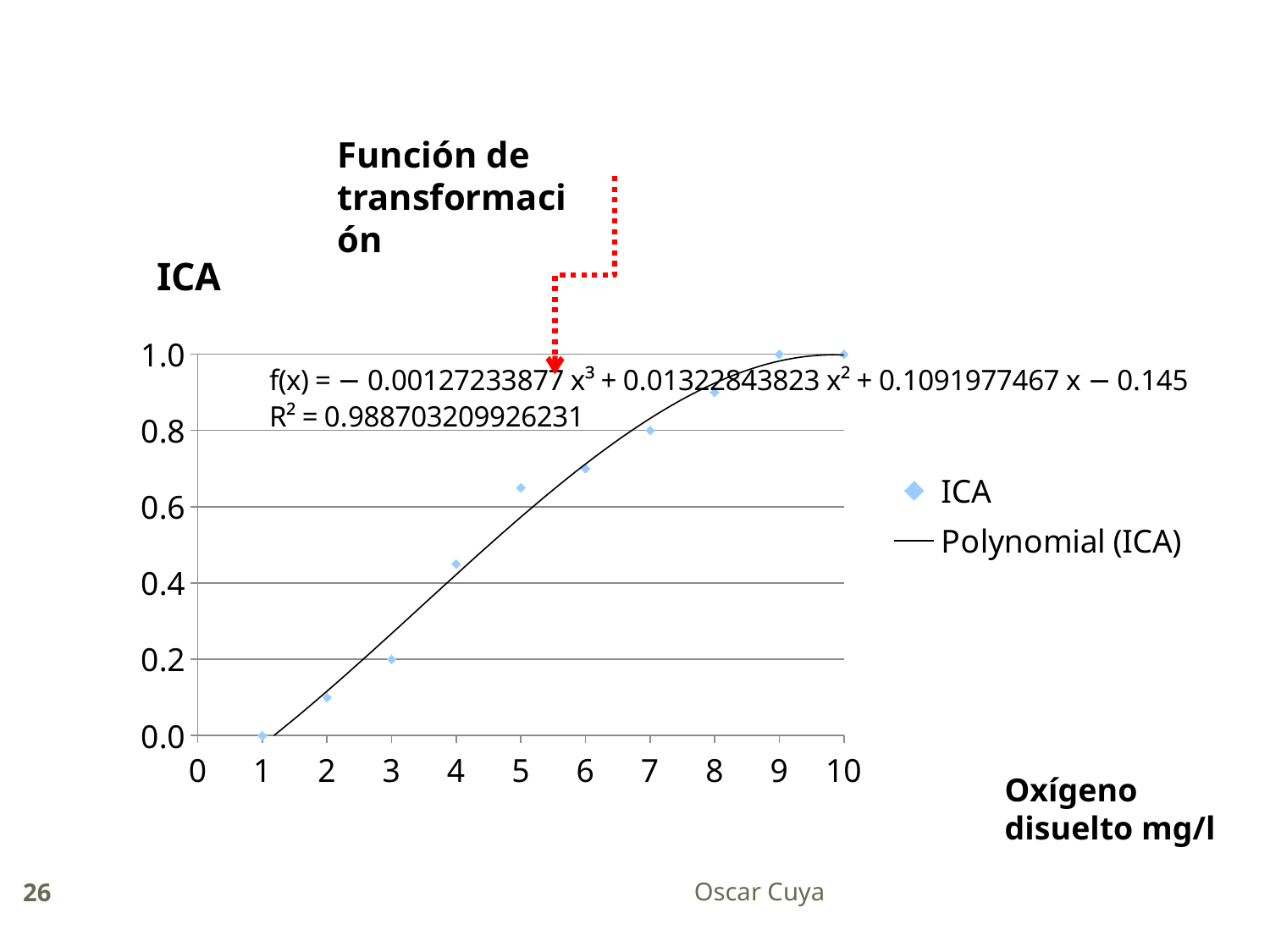
Do the ICA values rise or fall as oxígeno disuelto increases from 1 to 9 mg/l? rise What R² value is printed on the chart for the polynomial fit? 0.988703209926231 What is the ICA value at an oxígeno disuelto of 9 mg/l? 1.0 Is the ICA value at 5 mg/l greater or less than 0.6? greater How many data points are plotted for the ICA series? 10 Which is larger, the ICA value at 2 mg/l or at 6 mg/l? 6 mg/l Is the ICA value at 4 mg/l greater or less than 0.6? less What kind of chart is shown on the slide? scatter chart How many entries does the legend list? 2 What is the ICA value at an oxígeno disuelto of 1 mg/l? 0.0 Is the ICA value at 7 mg/l greater or less than 0.6? greater What is the ICA value at an oxígeno disuelto of 3 mg/l? 0.2